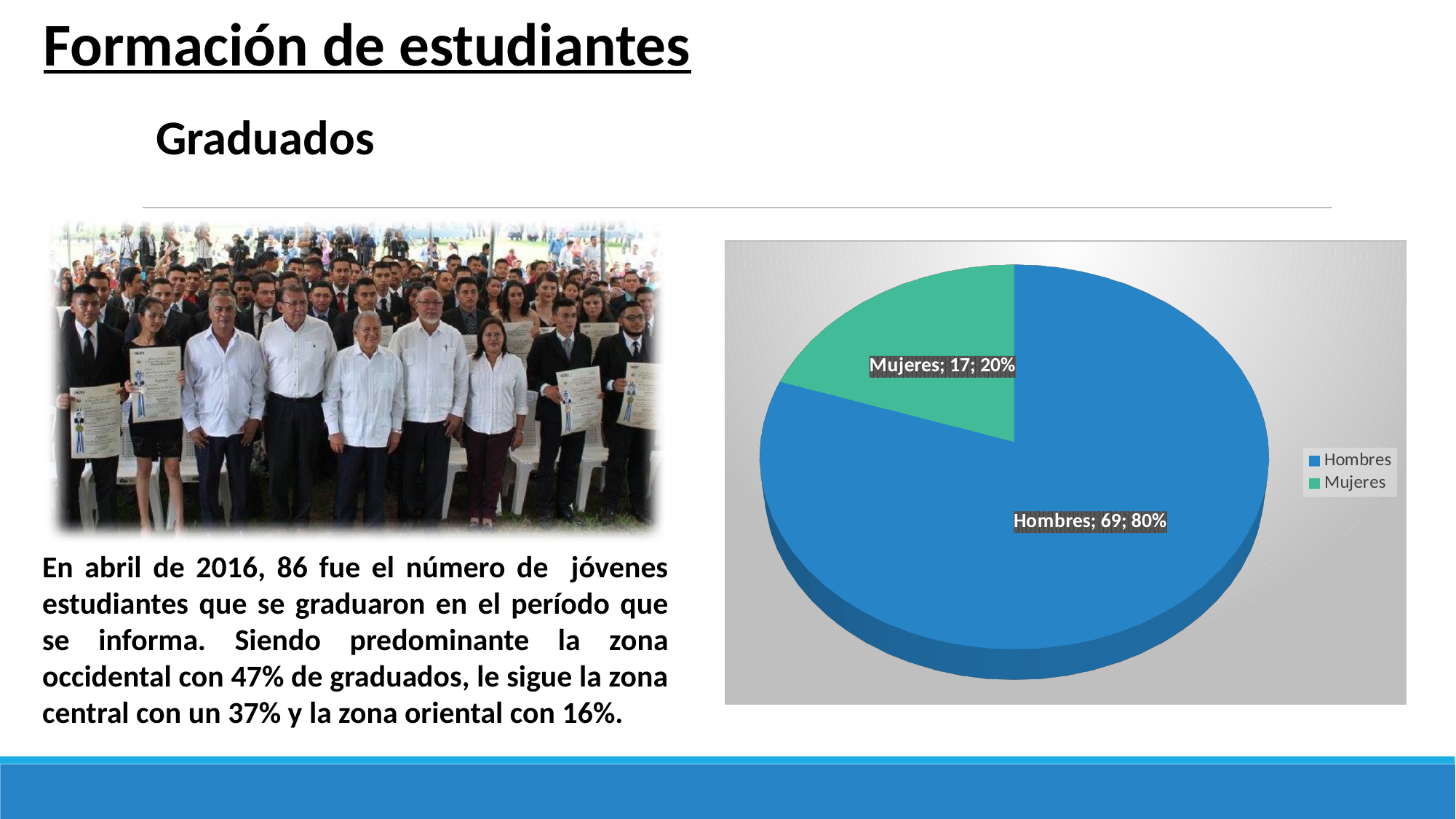
How many entries does the legend of the pie chart list? 2 How many slices does the pie chart have? 2 What colour is the Mujeres slice in the pie chart? green What is the difference between the values for Hombres and Mujeres? 52 What is the total of the values shown in the pie chart? 86 What kind of chart is shown on the slide? pie chart What share of the pie does Hombres represent? 80% Which category has the largest slice in the pie chart? Hombres Which category has the smallest slice in the pie chart? Mujeres What is the value for Mujeres in the pie chart? 17 What share of the pie does Mujeres represent? 20% What is the value for Hombres in the pie chart? 69